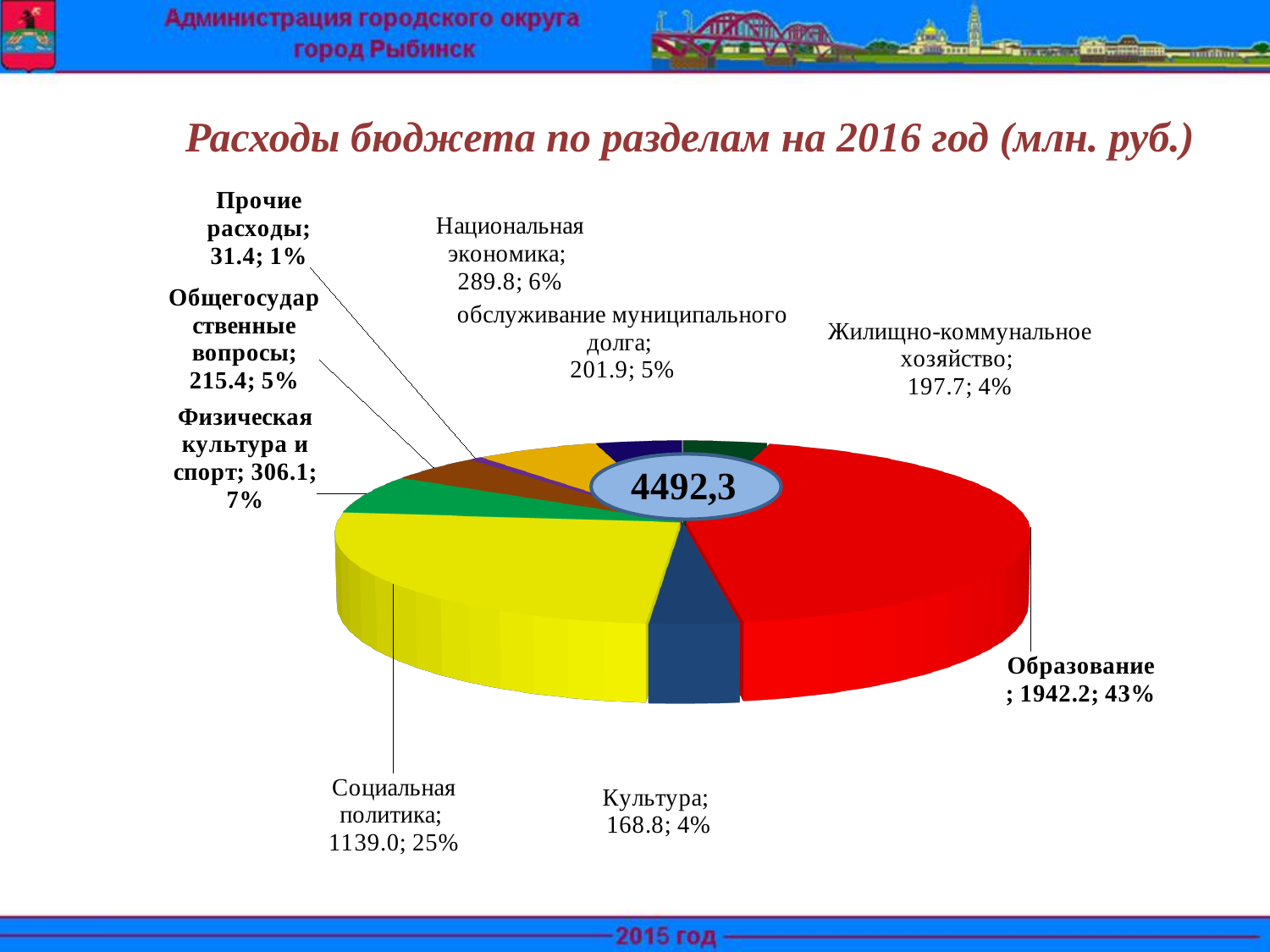
What total value is printed in the centre of the pie chart? 4492,3 Which is larger, the value for Физическая культура и спорт or the value for Общегосударственные вопросы? Физическая культура и спорт What is the value for Культура? 168.8 How many categories are shown in the pie chart? 9 Which category has the largest slice of the pie? Образование What kind of chart is shown on the slide? pie chart What is the difference between the values for Образование and Социальная политика? 803.2 What share of the pie does Социальная политика take? 25% What share of the pie does Жилищно-коммунальное хозяйство take? 4% What is the value for Национальная экономика? 289.8 Which category has the smallest slice of the pie? Прочие расходы What is the value for Образование? 1942.2